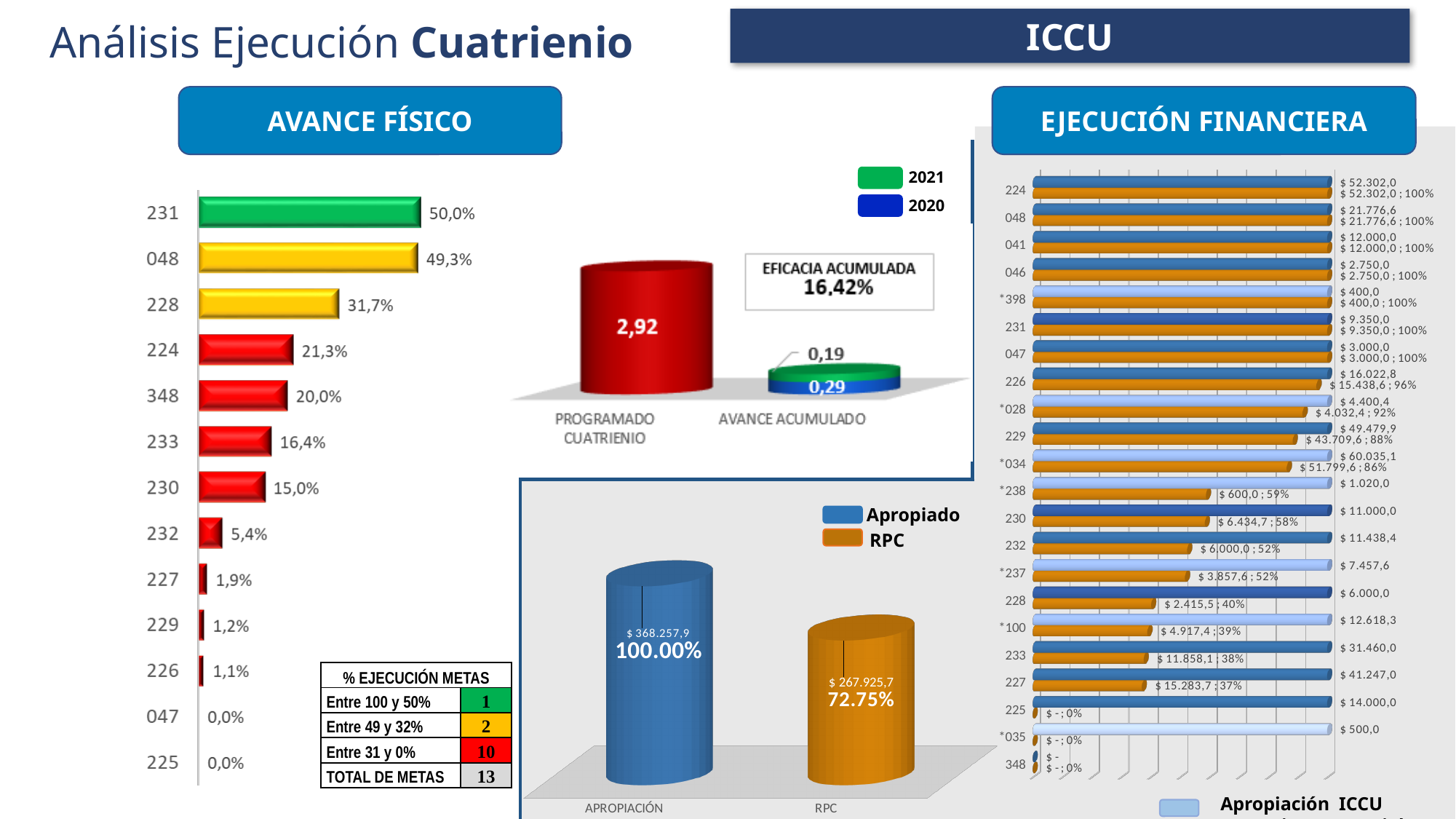
In the EJECUCIÓN FINANCIERA chart, what is the Apropiación value for category 227? $ 41.247,0 In the AVANCE FÍSICO bar chart, which category has the highest value? 231 In the APROPIACIÓN / RPC chart at the bottom centre, what amount is printed on the RPC cylinder? $ 267.925,7 In the EJECUCIÓN FINANCIERA chart, what percentage is shown next to the RPC bar for category 230? 58% What are the two legend entries of the APROPIACIÓN / RPC chart at the bottom centre? Apropiado and RPC In the AVANCE FÍSICO bar chart, what is the value for category 228? 31,7% In the PROGRAMADO CUATRIENIO / AVANCE ACUMULADO chart, what value is printed on the PROGRAMADO CUATRIENIO cylinder? 2,92 What kind of chart is the AVANCE FÍSICO chart? bar chart How many categories are plotted in the AVANCE FÍSICO bar chart? 13 How many series does the legend of the PROGRAMADO CUATRIENIO / AVANCE ACUMULADO chart list? 2 In the EJECUCIÓN FINANCIERA chart, which has the larger Apropiación value, category 224 or category 229? 224 In the AVANCE FÍSICO bar chart, what is the difference between the values for 231 and 048? 0,7%